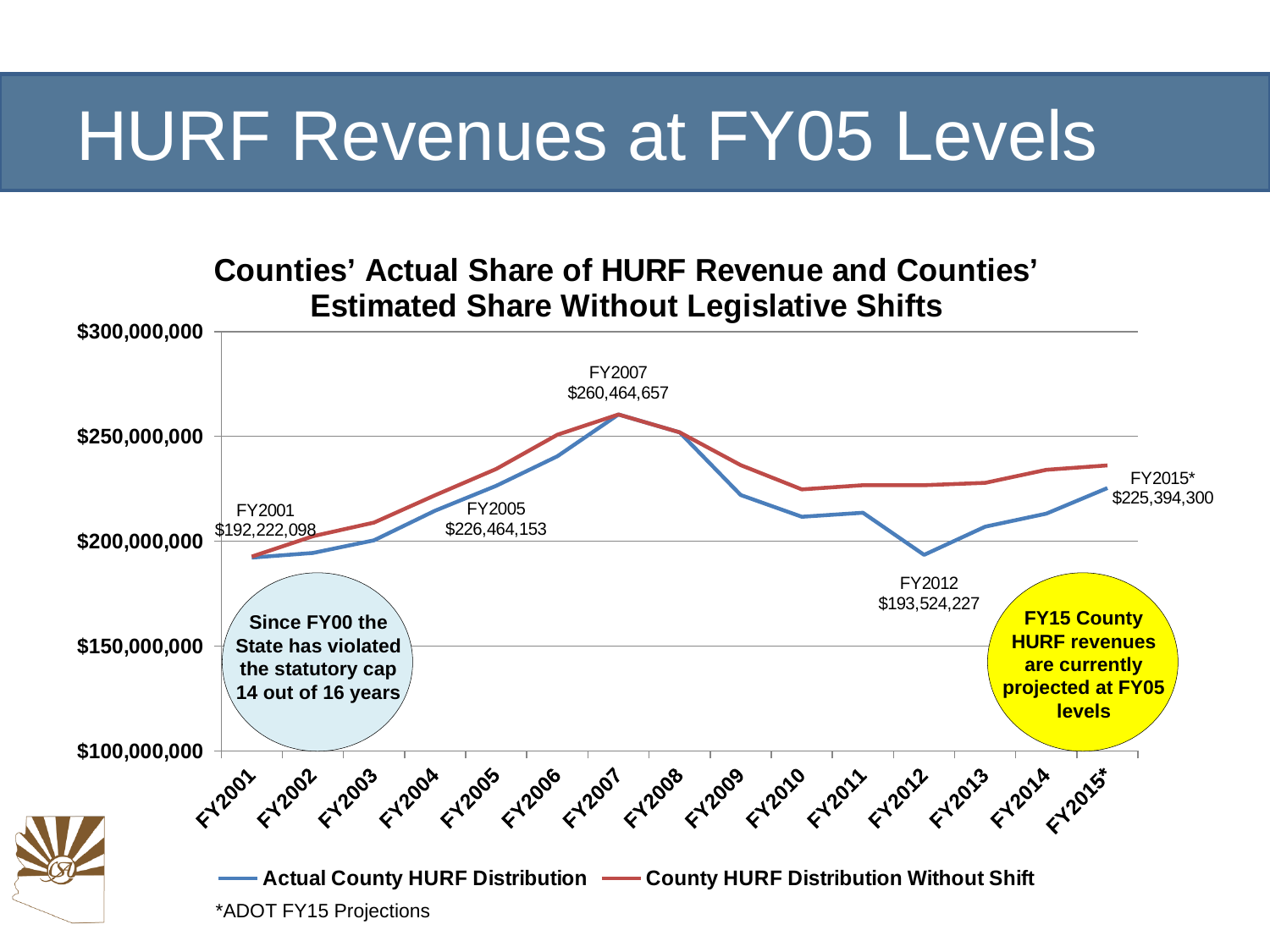
Is the Actual County HURF Distribution value for FY2010 greater or less than $250,000,000? less Which series is drawn in red? County HURF Distribution Without Shift How many series does the legend list? 2 What is the labelled value for the Actual County HURF Distribution in FY2007? $260,464,657 What is the labelled value for the Actual County HURF Distribution in FY2001? $192,222,098 What kind of chart is shown on the slide? line chart What is the labelled value for the Actual County HURF Distribution in FY2012? $193,524,227 What is the labelled value for the Actual County HURF Distribution in FY2015*? $225,394,300 In which fiscal year does the Actual County HURF Distribution reach its highest value? FY2007 Which is larger for the Actual County HURF Distribution: the FY2005 value or the FY2015* value? FY2005 What is the difference between the labelled FY2007 value and the labelled FY2005 value for the Actual County HURF Distribution? $34,000,504 How many fiscal years are shown along the x axis? 15